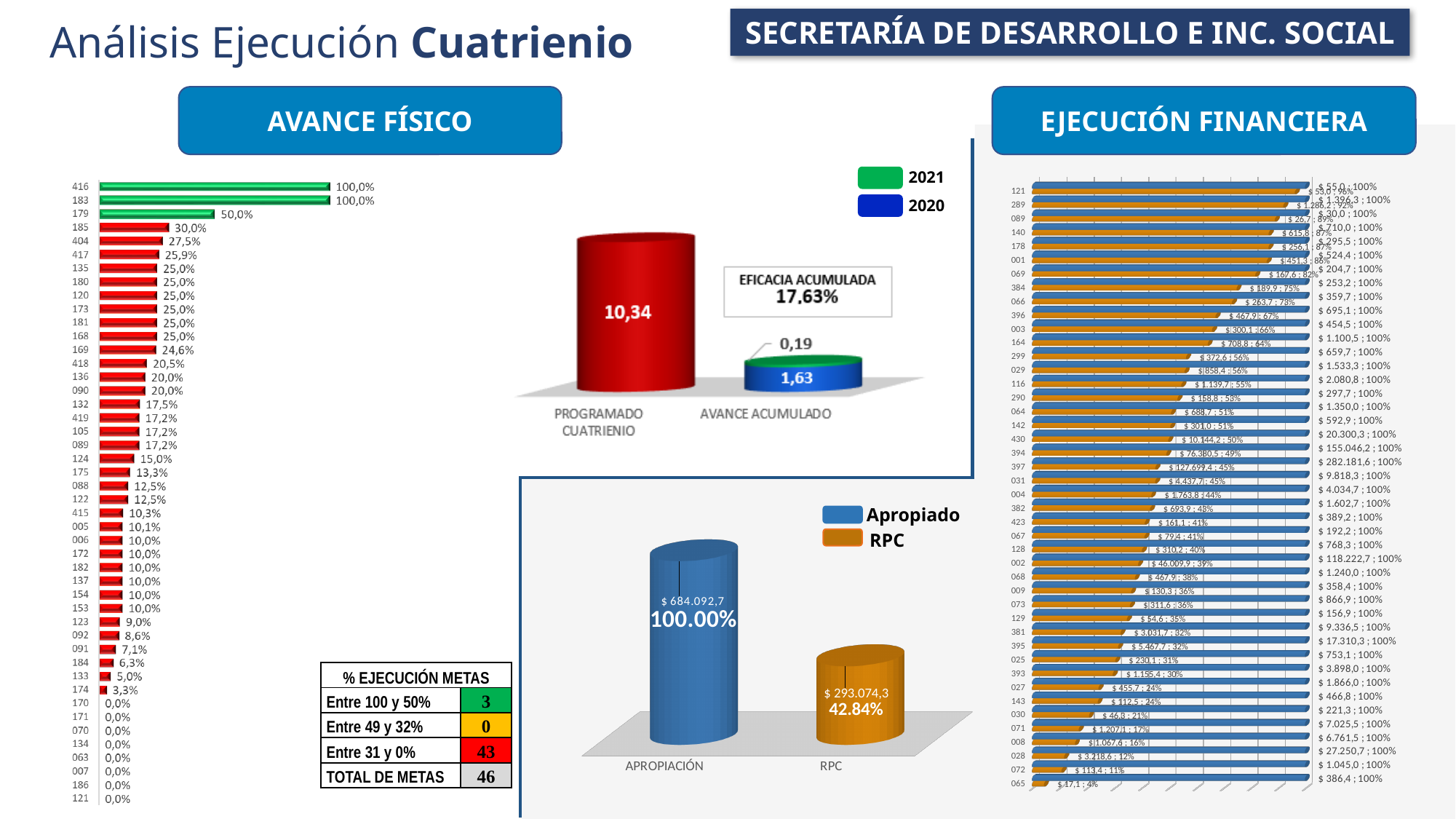
In the middle chart with PROGRAMADO CUATRIENIO and AVANCE ACUMULADO, what is the value of the PROGRAMADO CUATRIENIO bar? 10,34 How many series does the legend of the middle PROGRAMADO CUATRIENIO / AVANCE ACUMULADO chart list? 2 In the EJECUCIÓN FINANCIERA chart on the right, what percentage is shown for the RPC bar of category 065? 4% In the AVANCE FÍSICO chart on the left, what is the value for category 179? 50,0% In the bottom-middle chart with APROPIACIÓN and RPC, which bar is larger? APROPIACIÓN In the bottom-middle chart with APROPIACIÓN and RPC, what is the dollar value shown for RPC? $ 293.074,3 What kind of chart is the AVANCE FÍSICO chart on the left of the slide? bar chart In the EJECUCIÓN FINANCIERA chart on the right, what is the Apropiado value for category 430? $ 20.300,3 In the AVANCE FÍSICO chart on the left, what is the value for category 185? 30,0% In the middle chart with PROGRAMADO CUATRIENIO and AVANCE ACUMULADO, what is the value of the blue (2020) portion of the AVANCE ACUMULADO bar? 1,63 In the AVANCE FÍSICO chart on the left, what is the difference between the values for categories 185 and 404? 2,5% In the AVANCE FÍSICO chart on the left, what is the value for category 174? 3,3%